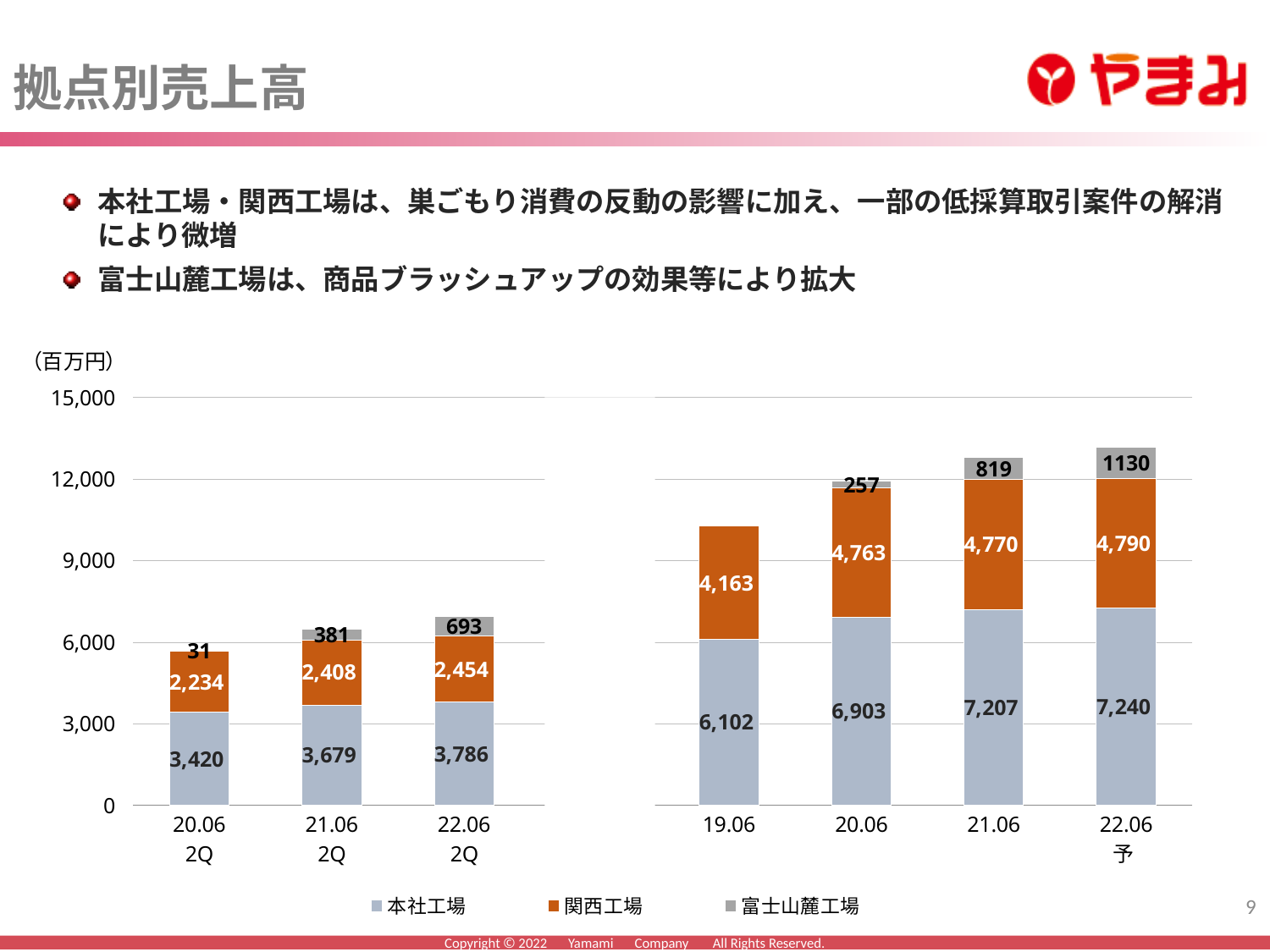
How many periods are shown on the right chart? 4 On the right chart, what is the value for 関西工場 in 19.06? 4,163 On the right chart, what is the difference between the 本社工場 values for 22.06 予 and 21.06? 33 On the left chart, which is larger: 関西工場 in 21.06 2Q or 関西工場 in 20.06 2Q? 21.06 2Q On the left chart, what is the value for 本社工場 in 22.06 2Q? 3,786 What type of chart is used on this slide? Stacked bar chart On the right chart, which period has the lowest value for 本社工場? 19.06 On the left chart, which period has the highest value for 富士山麓工場? 22.06 2Q On the right chart, what is the value for 富士山麓工場 in 22.06 予? 1130 On the right chart, what is the total of the stacked bar for 22.06 予? 13,160 On the right chart, is the total stacked bar for 19.06 greater or less than 9,000? greater How many series does the legend list? 3